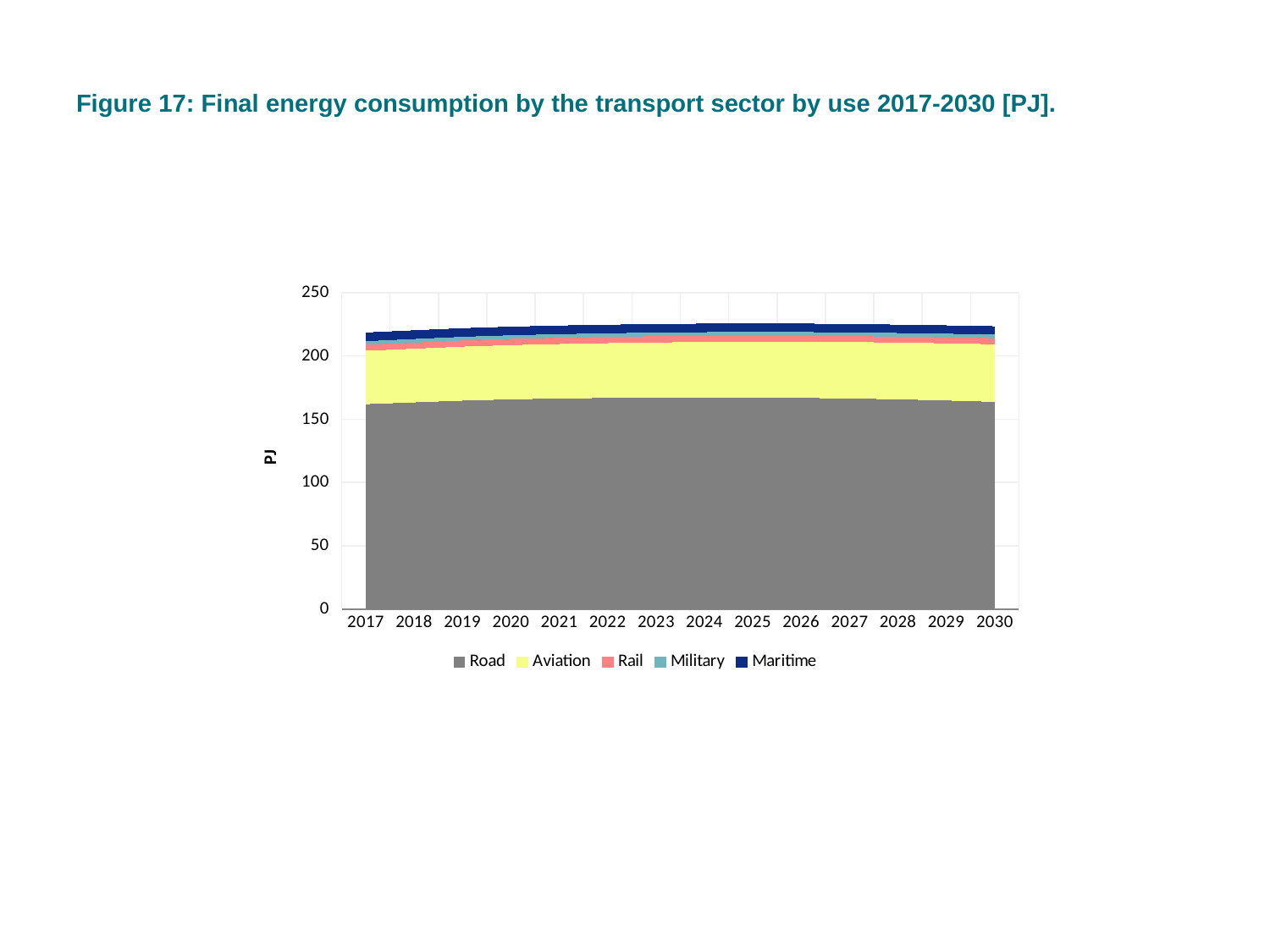
What is the first year shown on the x axis? 2017 How many series does the legend list? 5 What kind of chart is shown on the slide? stacked area chart How many years are shown along the x axis? 14 Is the value for Road in 2025 greater or less than 200? less Is the total energy consumption in 2017 greater or less than 200? greater What is the title of the chart? Figure 17: Final energy consumption by the transport sector by use 2017-2030 [PJ]. Which series accounts for the largest share of transport energy consumption? Road Which is larger in 2020, the value for Road or the value for Aviation? Road What is the label on the y axis? PJ Is the total energy consumption in 2030 greater or less than 250? less